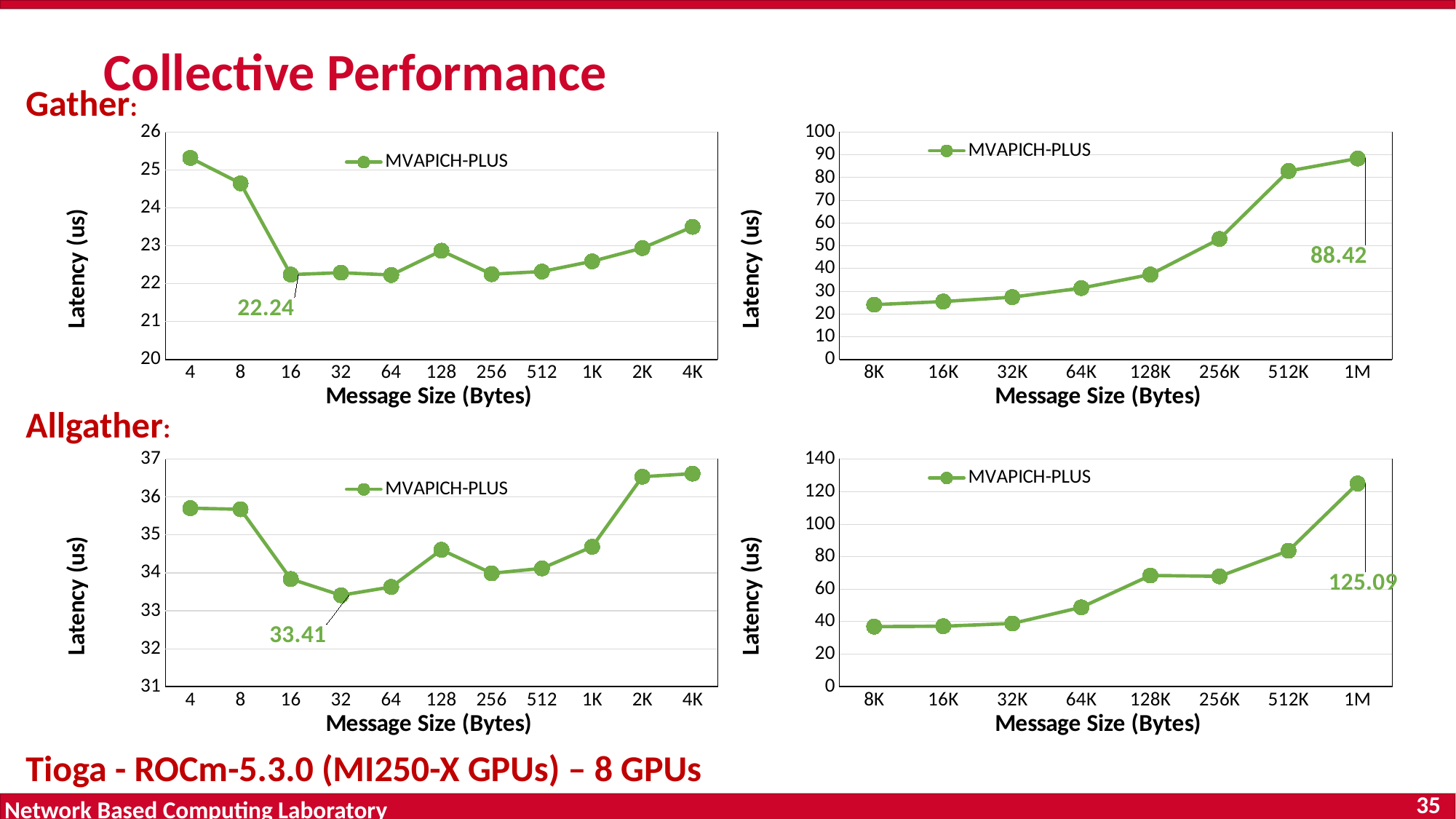
In the top-left Gather chart (message sizes 4 to 4K bytes), what latency value is labelled on the plot? 22.24 In the bottom-right Allgather chart, which message size has the highest latency? 1M In the bottom-left Allgather chart (message sizes 4 to 4K bytes), what latency value is labelled on the plot? 33.41 How many message sizes are plotted on the x axis of the bottom-left Allgather chart? 11 In the top-right Gather chart (message sizes 8K to 1M bytes), what is the labelled latency at 1M bytes? 88.42 In the top-right Gather chart, is the latency at 128K bytes greater or less than 40? less In the top-right Gather chart, which message size has the highest latency? 1M How many series does the legend of the top-right Gather chart list? 1 In the bottom-right Allgather chart (message sizes 8K to 1M bytes), what is the labelled latency at 1M bytes? 125.09 In the top-left Gather chart, which message size has the highest latency? 4 In the bottom-right Allgather chart, is the latency at 64K bytes greater or less than 40? greater What type of chart is the bottom-right Allgather chart? Line chart